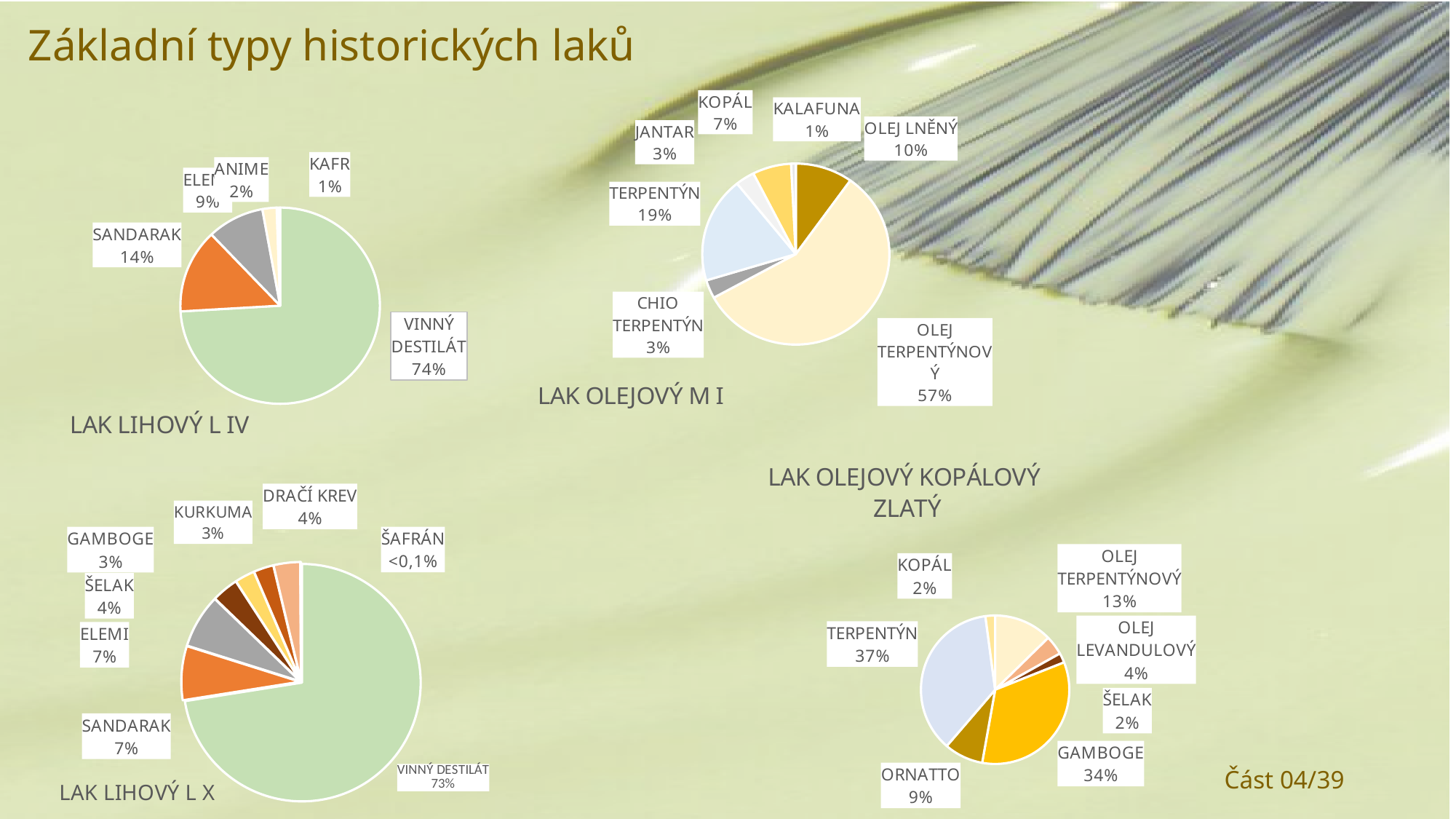
In the LAK OLEJOVÝ KOPÁLOVÝ ZLATÝ chart, which is larger, TERPENTÝN or GAMBOGE? TERPENTÝN In the LAK OLEJOVÝ KOPÁLOVÝ ZLATÝ chart, what is the value for ORNATTO? 9% In the LAK OLEJOVÝ M I chart, which ingredient has the largest slice? OLEJ TERPENTÝNOVÝ In the LAK OLEJOVÝ M I chart, what is the value for TERPENTÝN? 19% In the LAK LIHOVÝ L IV chart, what share does VINNÝ DESTILÁT have? 74% In the LAK LIHOVÝ L X chart, what is the value for ŠAFRÁN? <0,1% In the LAK LIHOVÝ L IV chart, what is the value for SANDARAK? 14% In the LAK OLEJOVÝ M I chart, which ingredient has the smallest slice? KALAFUNA In the LAK OLEJOVÝ M I chart, what is the difference between OLEJ LNĚNÝ and KOPÁL? 3% How many slices does the LAK LIHOVÝ L X chart have? 8 In the LAK OLEJOVÝ KOPÁLOVÝ ZLATÝ chart, what is the difference between OLEJ TERPENTÝNOVÝ and OLEJ LEVANDULOVÝ? 9% What type of chart is used for LAK LIHOVÝ L IV? Pie chart